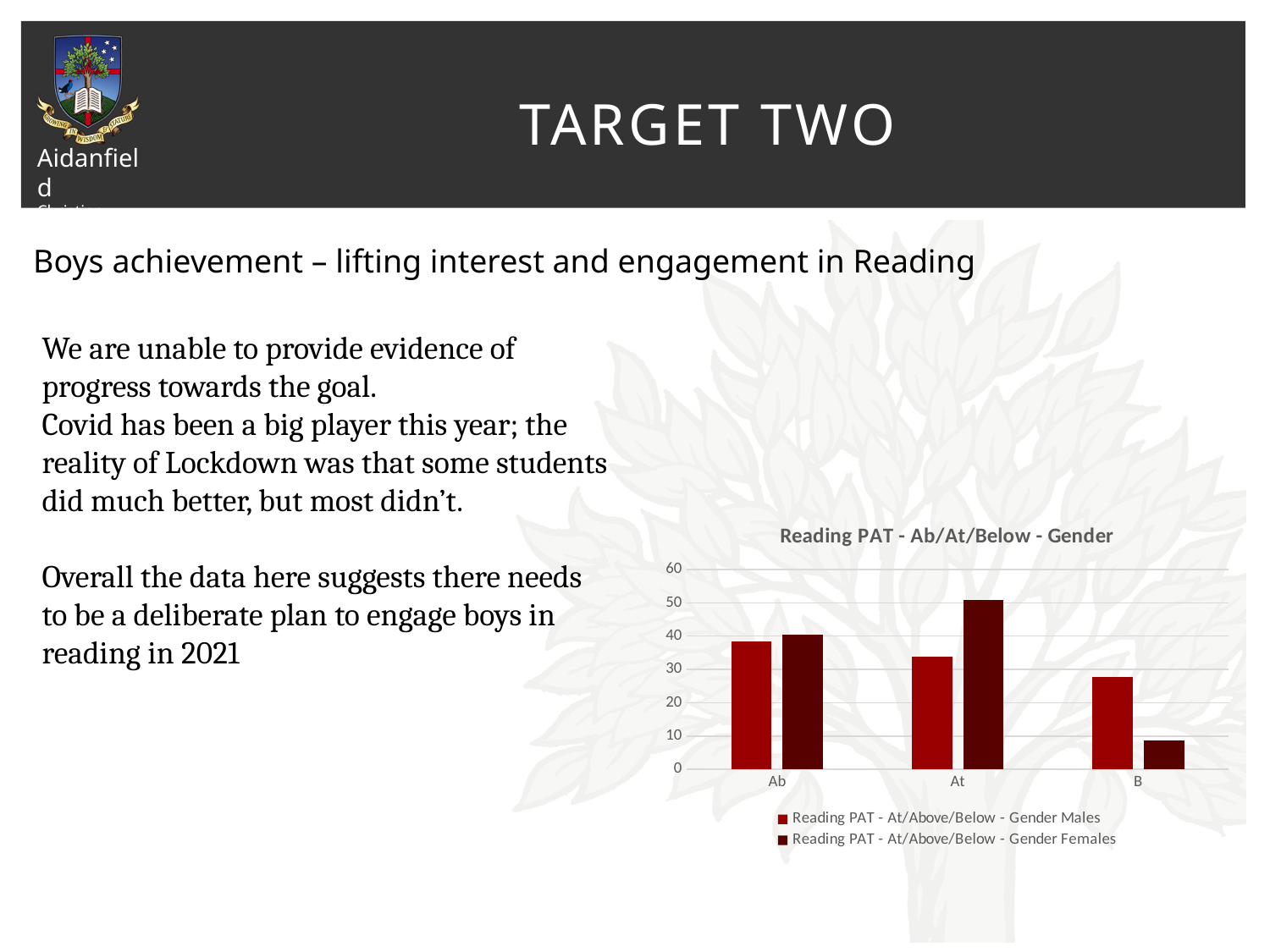
What is the title of the chart? Reading PAT - Ab/At/Below - Gender In the At category, which series has the larger value, Males or Females? Females How many series does the chart's legend list? 2 What kind of chart is shown on the slide? bar chart Is the value for Females in the At category greater or less than 40? greater How many categories are shown on the x axis of the chart? 3 In the B category, which series has the larger value, Males or Females? Males For the Females series, which category has the highest value? At For the Males series, which category has the lowest value? B Do the values for the Males series rise or fall from Ab to B along the x axis? fall For the Females series, which category has the lowest value? B